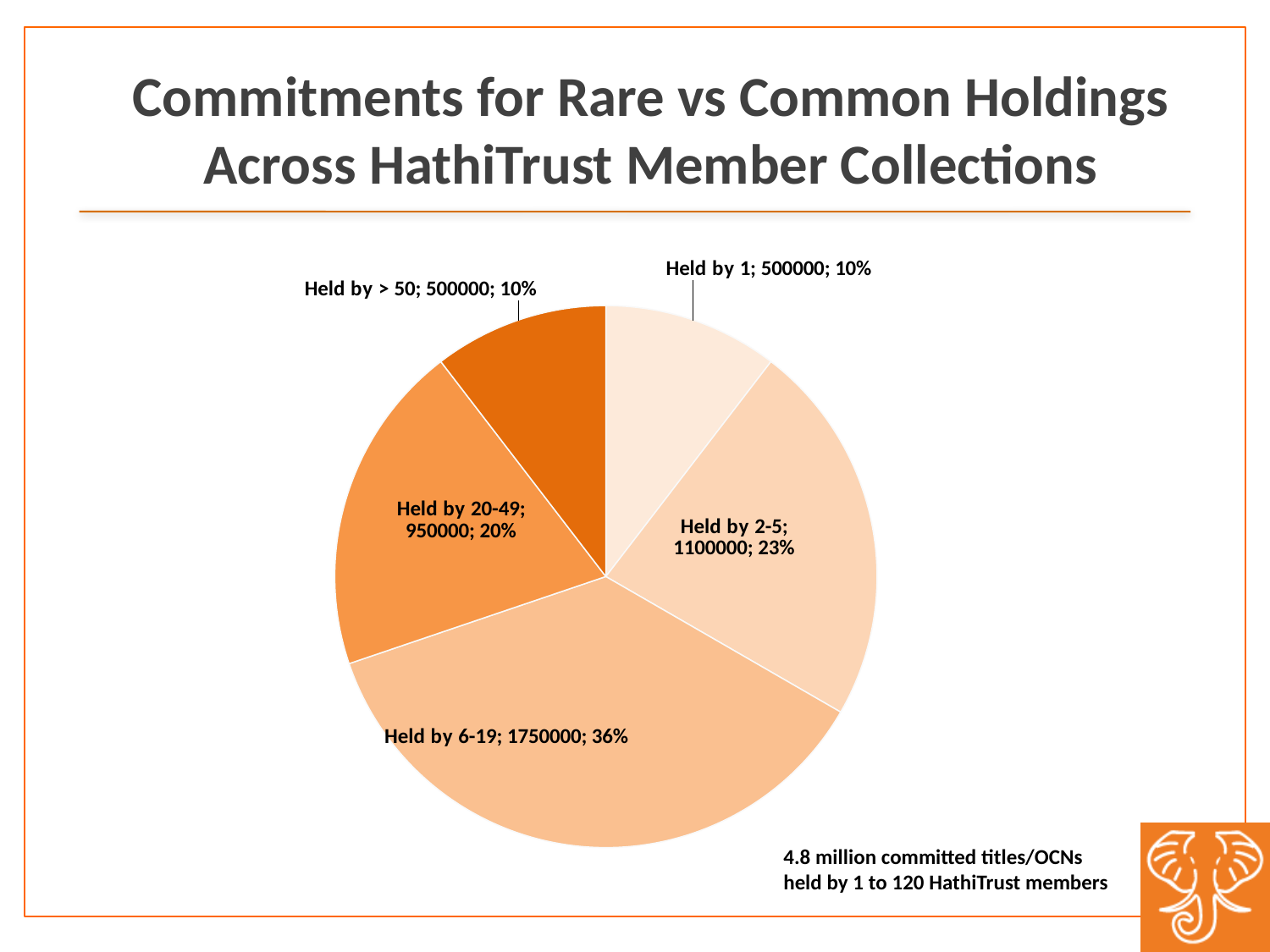
What kind of chart is shown on the slide? pie chart Which is larger, the value for 'Held by 20-49' or the value for 'Held by 1'? Held by 20-49 Which category has the largest slice of the pie? Held by 6-19 What is the value for the 'Held by 20-49' slice? 950000 What is the difference between the values for 'Held by 6-19' and 'Held by 2-5'? 650000 What is the value for the 'Held by 1' slice? 500000 What percentage share does the 'Held by 2-5' slice represent? 23% What is the value for the 'Held by 6-19' slice? 1750000 How many slices does the pie chart have? 5 What is the difference between the values for 'Held by 20-49' and 'Held by > 50'? 450000 What is the title of the slide containing the pie chart? Commitments for Rare vs Common Holdings Across HathiTrust Member Collections What percentage share does the 'Held by > 50' slice represent? 10%